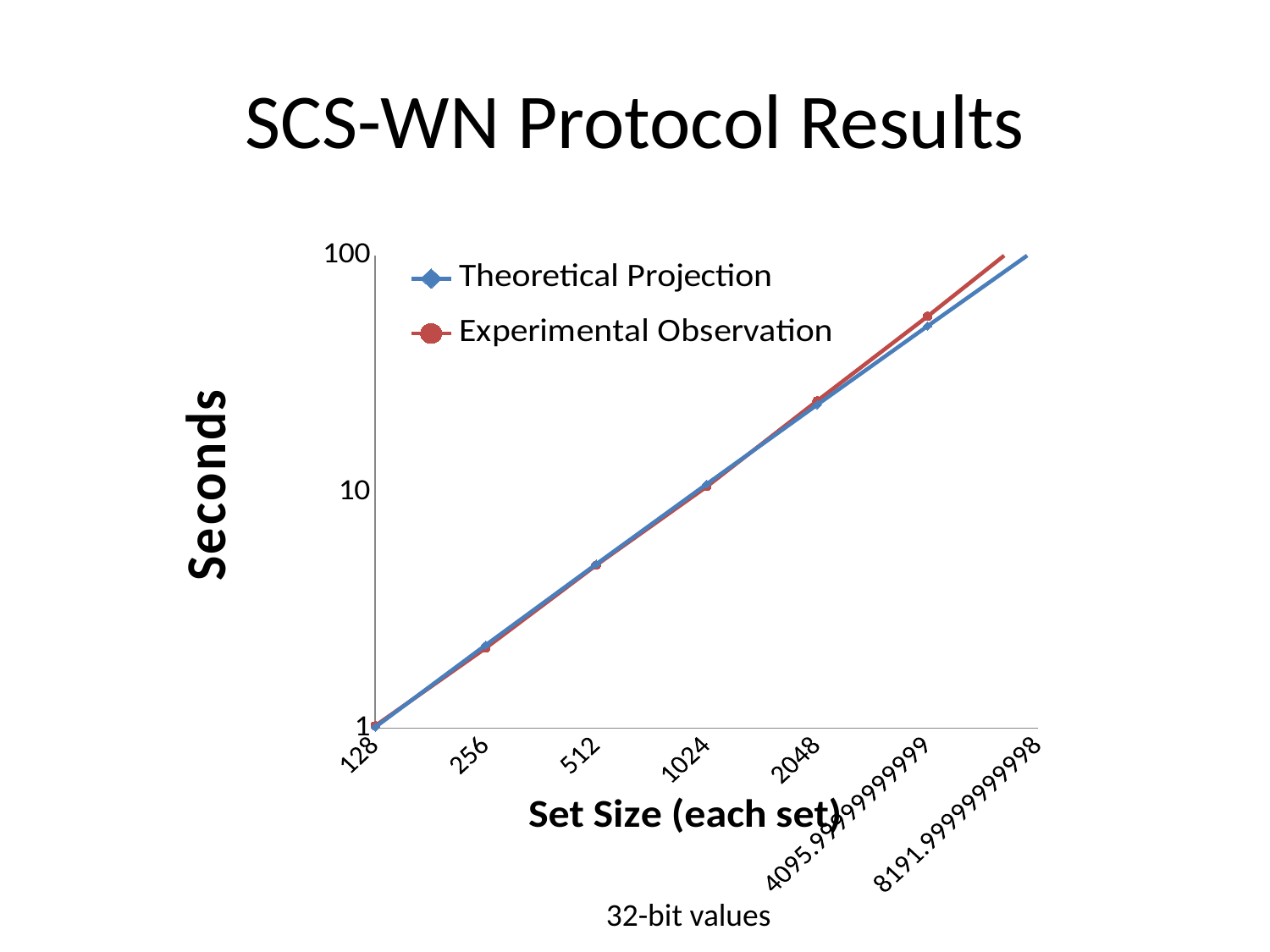
What is the title of the chart? SCS-WN Protocol Results What kind of chart is shown on the slide? line chart Which set size has the highest Theoretical Projection value? 8191.99999999998 How many series does the legend list? 2 Which set size has the lowest Theoretical Projection value? 128 Is the Experimental Observation value at set size 512 greater or less than 10 seconds? less Is the Theoretical Projection value at set size 2048 greater or less than 10 seconds? greater What is the label of the y axis? Seconds Is the Experimental Observation value at set size 4095.99999999999 greater or less than 100 seconds? less How many set-size categories are shown on the x axis? 7 Do the values rise or fall as set size increases along the x axis? rise